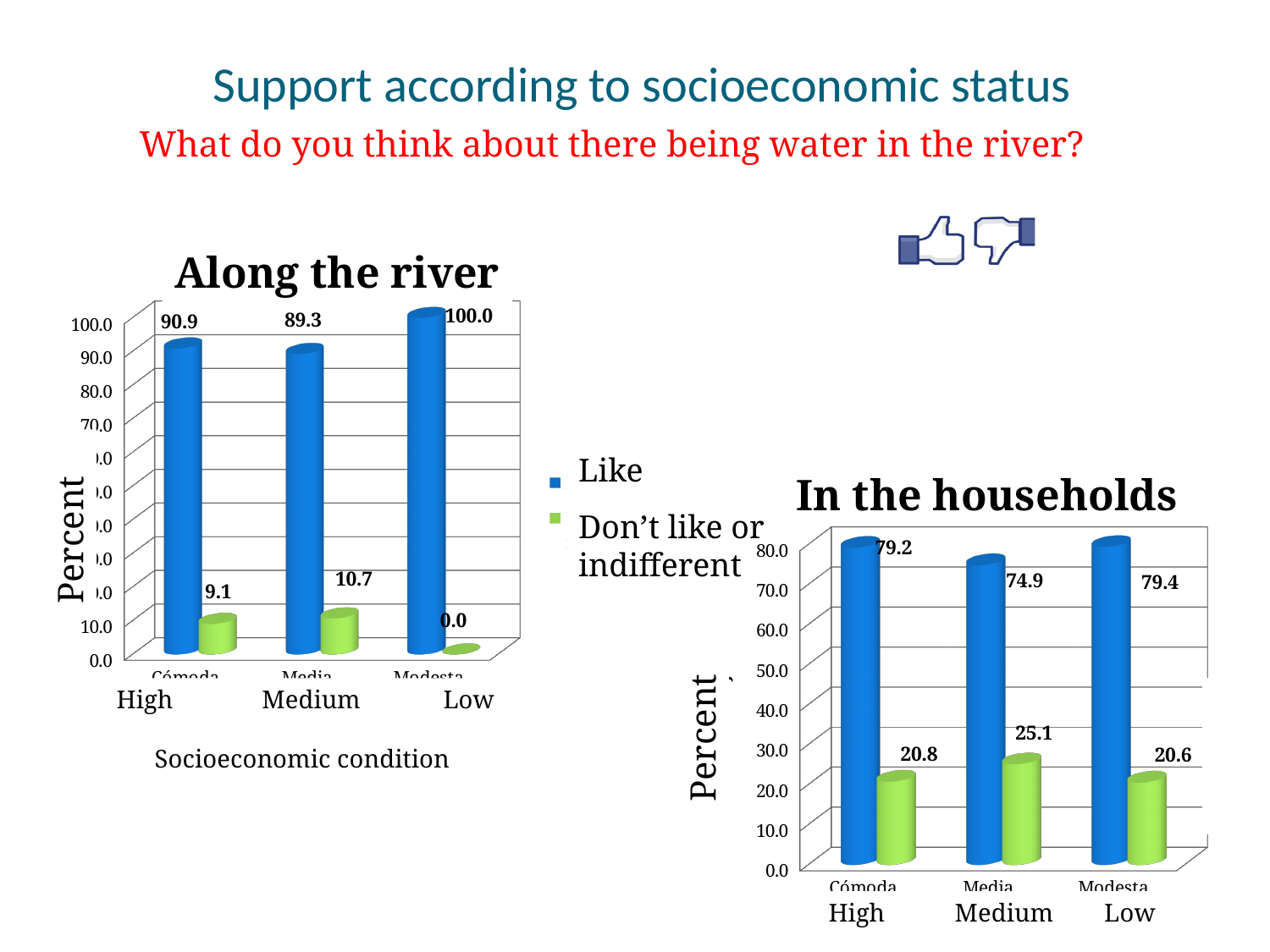
In the 'Along the river' chart, what is the value for Don't like or indifferent in the Medium group? 10.7 In the 'Along the river' chart, what is the value for Like in the High socioeconomic group? 90.9 In the 'Along the river' chart, what is the difference between the Like values for High and Medium? 1.6 In the 'Along the river' chart, which socioeconomic group has the highest Like value? Low What kind of chart is 'Along the river'? Bar chart In the 'In the households' chart, what is the difference between the Like and Don't like or indifferent values for the Medium group? 49.8 In the 'In the households' chart, which group has the highest Don't like or indifferent value? Medium In the 'In the households' chart, what is the value for Like in the Medium group? 74.9 In the 'In the households' chart, which socioeconomic group has the lowest Like value? Medium In the 'In the households' chart, what is the value for Don't like or indifferent in the Low group? 20.6 In the 'In the households' chart, is the Like value for High larger or the Like value for Medium? High How many series does the legend list? 2